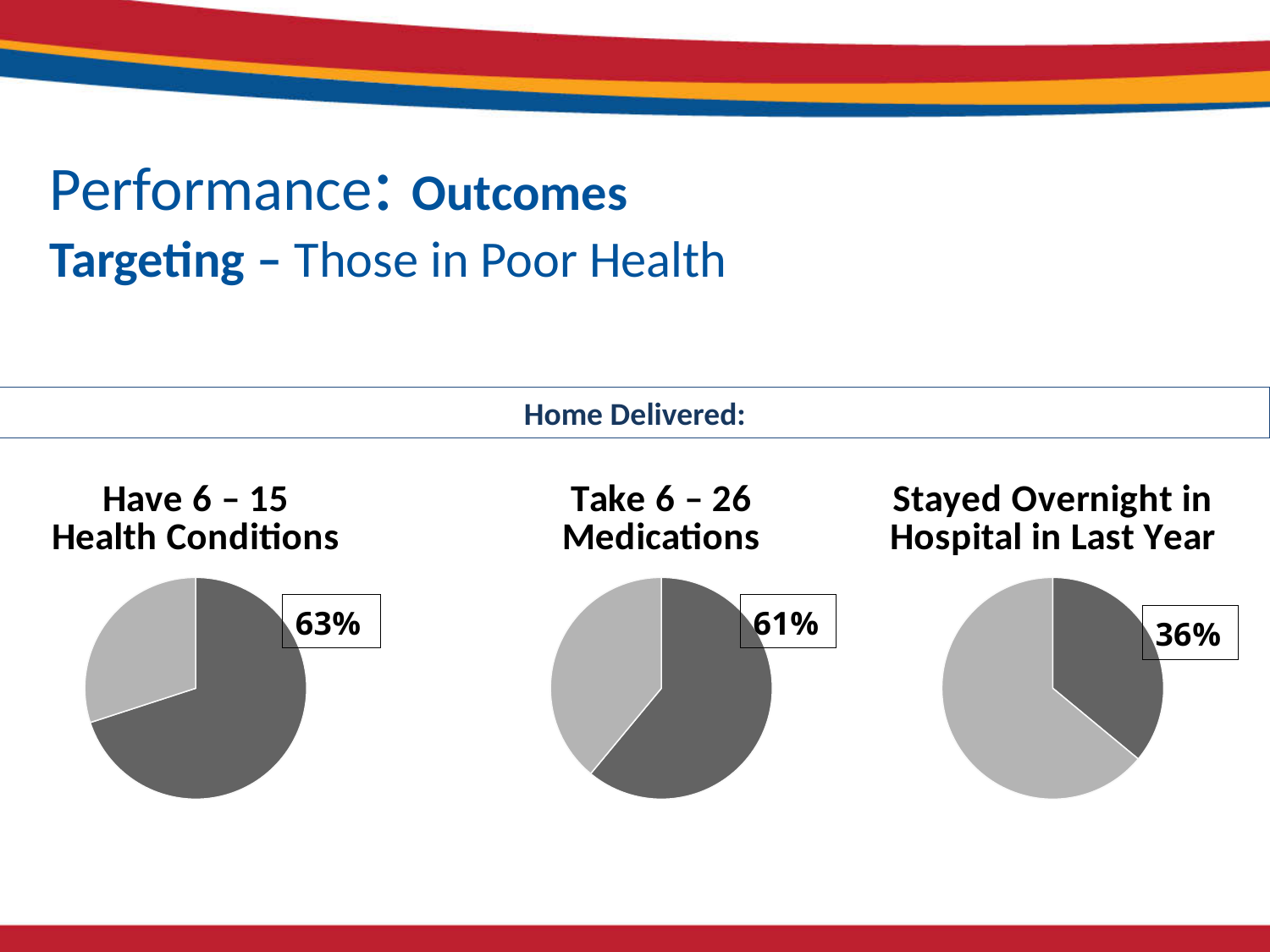
What is the difference in percentage points between the labelled value in the 'Have 6 – 15 Health Conditions' chart and the labelled value in the 'Stayed Overnight in Hospital in Last Year' chart? 27 percentage points What kind of chart is used for 'Have 6 – 15 Health Conditions'? Pie chart In the 'Take 6 – 26 Medications' chart, what percentage is shown for the dark grey slice? 61% How many pie charts are shown on the slide? 3 Which chart shows the highest labelled percentage: 'Have 6 – 15 Health Conditions', 'Take 6 – 26 Medications', or 'Stayed Overnight in Hospital in Last Year'? Have 6 – 15 Health Conditions In the 'Have 6 – 15 Health Conditions' chart, what percentage is shown for the dark grey slice? 63% What heading appears in the box above the three pie charts? Home Delivered: In the 'Stayed Overnight in Hospital in Last Year' pie chart, is the dark grey slice greater or less than half of the pie? less How many slices does the 'Take 6 – 26 Medications' pie chart have? 2 Which chart shows the lowest labelled percentage: 'Have 6 – 15 Health Conditions', 'Take 6 – 26 Medications', or 'Stayed Overnight in Hospital in Last Year'? Stayed Overnight in Hospital in Last Year Is the labelled percentage larger in the 'Have 6 – 15 Health Conditions' chart or the 'Stayed Overnight in Hospital in Last Year' chart? Have 6 – 15 Health Conditions In the 'Stayed Overnight in Hospital in Last Year' chart, what percentage is shown for the dark grey slice? 36%